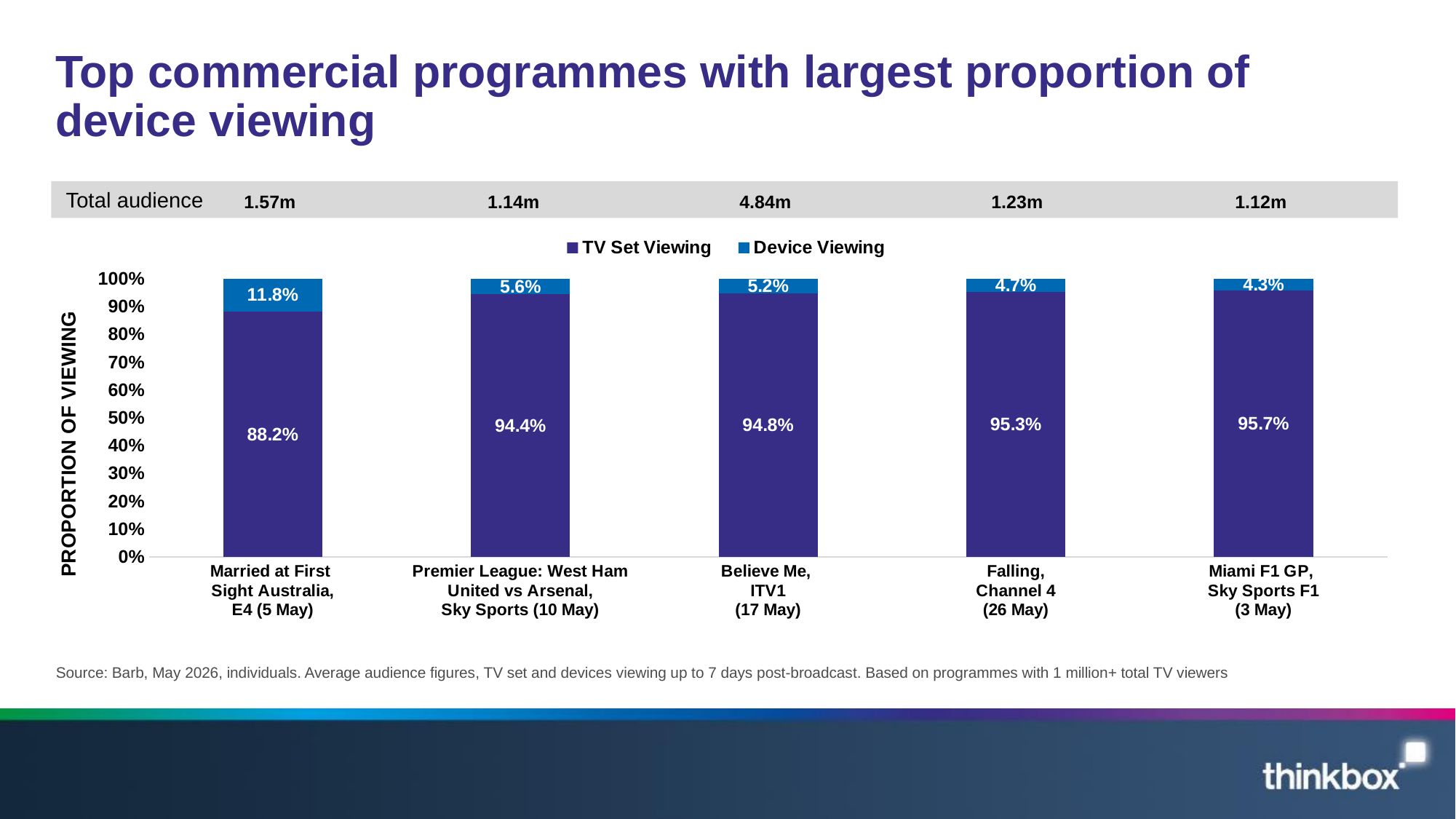
Which programme has the lowest TV Set Viewing proportion? Married at First Sight Australia, E4 (5 May) What is the TV Set Viewing value for Believe Me, ITV1 (17 May)? 94.8% Does the TV Set Viewing proportion rise or fall from left to right across the programmes? Rise What kind of chart is shown on the slide? Stacked bar chart Which has a larger TV Set Viewing proportion, Falling, Channel 4 (26 May) or Premier League: West Ham United vs Arsenal, Sky Sports (10 May)? Falling, Channel 4 (26 May) Which programme has the highest Device Viewing proportion? Married at First Sight Australia, E4 (5 May) What is the Device Viewing value for Miami F1 GP, Sky Sports F1 (3 May)? 4.3% How many series does the legend list? 2 How many programmes are shown on the chart? 5 What is the Device Viewing value for Married at First Sight Australia, E4 (5 May)? 11.8% What is the total audience shown for Believe Me, ITV1 (17 May)? 4.84m What is the difference between the Device Viewing values for Married at First Sight Australia and Premier League: West Ham United vs Arsenal? 6.2%